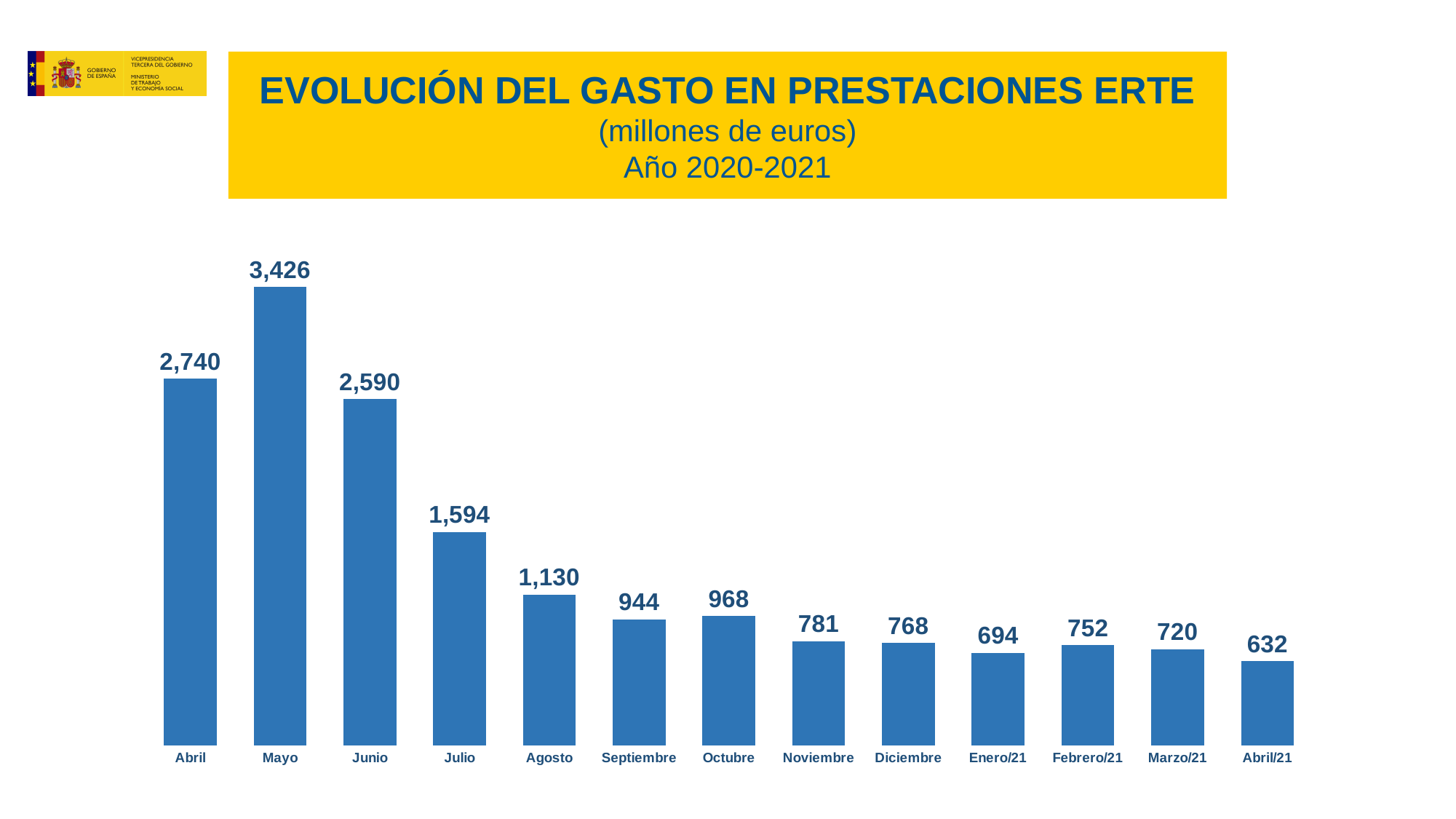
What is the value for Mayo? 3,426 Which is larger, the value for Octubre or the value for Noviembre? Octubre What is the difference between the values for Mayo and Junio? 836 How many months are shown on the chart? 13 What is the difference between the values for Julio and Agosto? 464 Which month has the lowest value? Abril/21 Which is larger, the value for Febrero/21 or the value for Marzo/21? Febrero/21 Which month has the highest value? Mayo What is the value for Abril/21? 632 What is the value for Septiembre? 944 What unit is stated in the chart title? millones de euros What kind of chart is shown on the slide? Bar chart